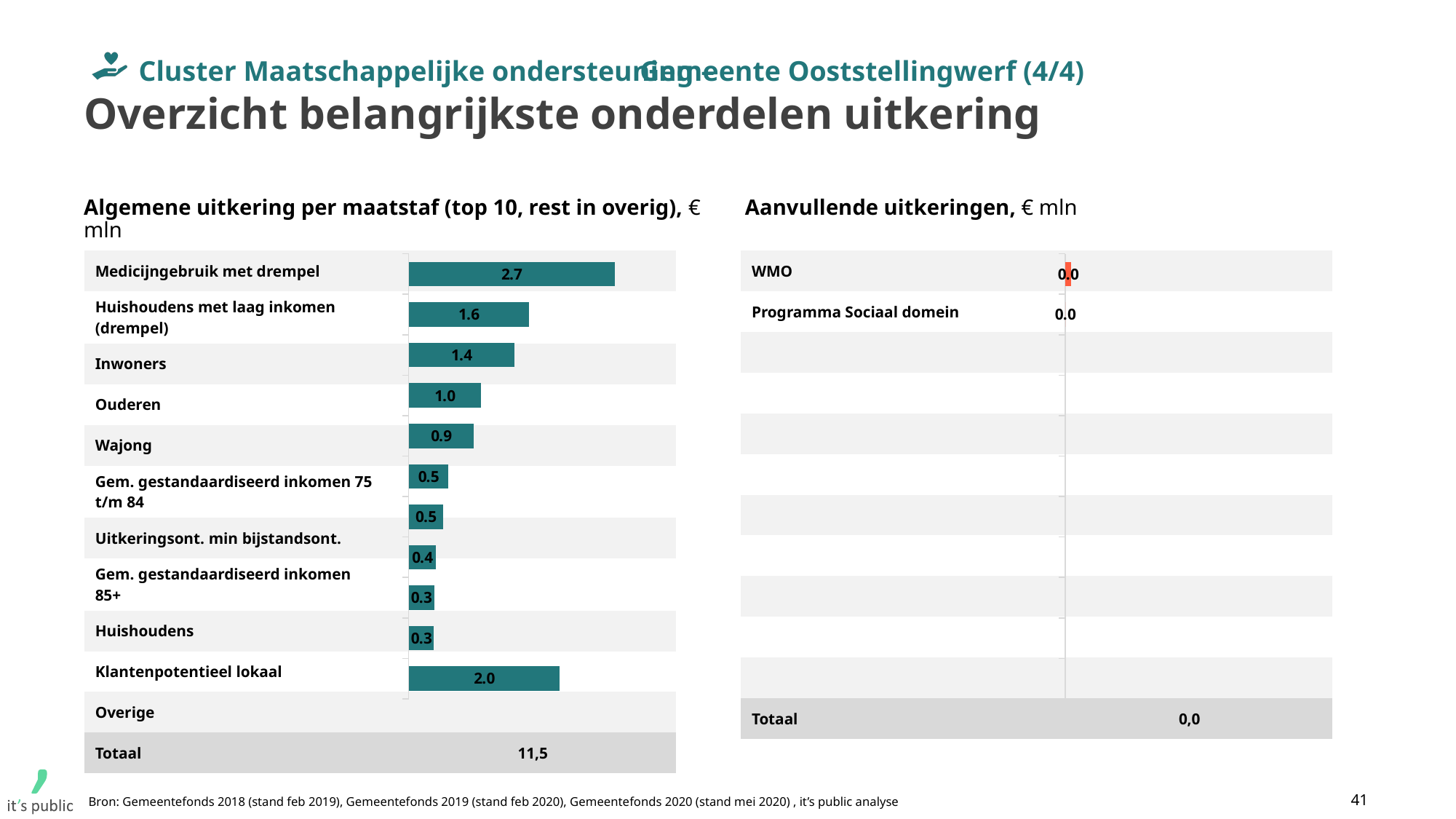
In the chart 'Algemene uitkering per maatstaf', what is the value for Wajong? 0.9 In the chart 'Algemene uitkering per maatstaf', what is the Totaal shown? 11,5 In the chart 'Algemene uitkering per maatstaf', what is the value for Medicijngebruik met drempel? 2.7 In the chart 'Algemene uitkering per maatstaf', which category has the highest value? Medicijngebruik met drempel In the chart 'Aanvullende uitkeringen', what is the value for WMO? 0.0 In the chart 'Algemene uitkering per maatstaf', what is the value for Ouderen? 1.0 In the chart 'Algemene uitkering per maatstaf', what is the difference between Medicijngebruik met drempel and Huishoudens met laag inkomen (drempel)? 1.1 In the chart 'Aanvullende uitkeringen', what is the Totaal shown? 0,0 In the chart 'Algemene uitkering per maatstaf', what is the value for Inwoners? 1.4 How many labelled categories does the chart 'Aanvullende uitkeringen' show (excluding Totaal)? 2 In the chart 'Algemene uitkering per maatstaf', which is larger: Inwoners or Wajong? Inwoners What kind of chart is 'Algemene uitkering per maatstaf'? Bar chart